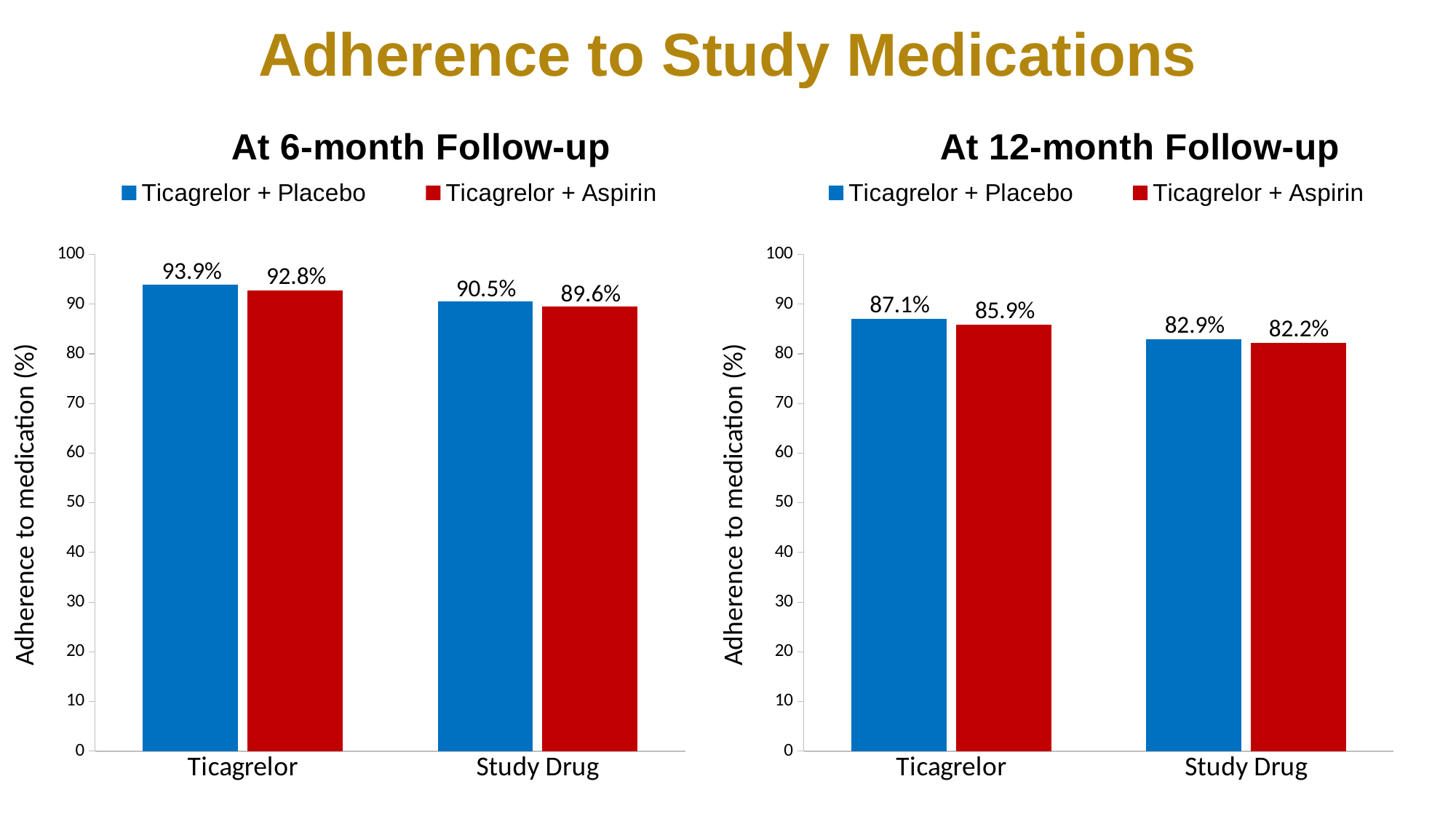
In the 'At 6-month Follow-up' chart, which bar has the lowest value? Ticagrelor + Aspirin, Study Drug (89.6%) In the 'At 12-month Follow-up' chart, what is the adherence value for Ticagrelor + Placebo in the Ticagrelor category? 87.1% In the 'At 12-month Follow-up' chart, what is the difference between the Ticagrelor + Placebo and Ticagrelor + Aspirin values in the Study Drug category? 0.7% In the 'At 6-month Follow-up' chart, what is the difference between the Ticagrelor + Placebo and Ticagrelor + Aspirin values in the Ticagrelor category? 1.1% How many series does the legend of the 'At 12-month Follow-up' chart list? 2 In the 'At 6-month Follow-up' chart, what is the adherence value for Ticagrelor + Aspirin in the Study Drug category? 89.6% In the 'At 12-month Follow-up' chart, what is the adherence value for Ticagrelor + Aspirin in the Study Drug category? 82.2% What type of chart is the 'At 12-month Follow-up' chart? Bar chart In the 'At 6-month Follow-up' chart, is the Ticagrelor + Placebo value for Study Drug greater or less than 80? greater In the 'At 12-month Follow-up' chart, which bar has the highest value? Ticagrelor + Placebo, Ticagrelor (87.1%) In the 'At 6-month Follow-up' chart, what is the adherence value for Ticagrelor + Placebo in the Ticagrelor category? 93.9% How many categories are shown on the x axis of the 'At 6-month Follow-up' chart? 2